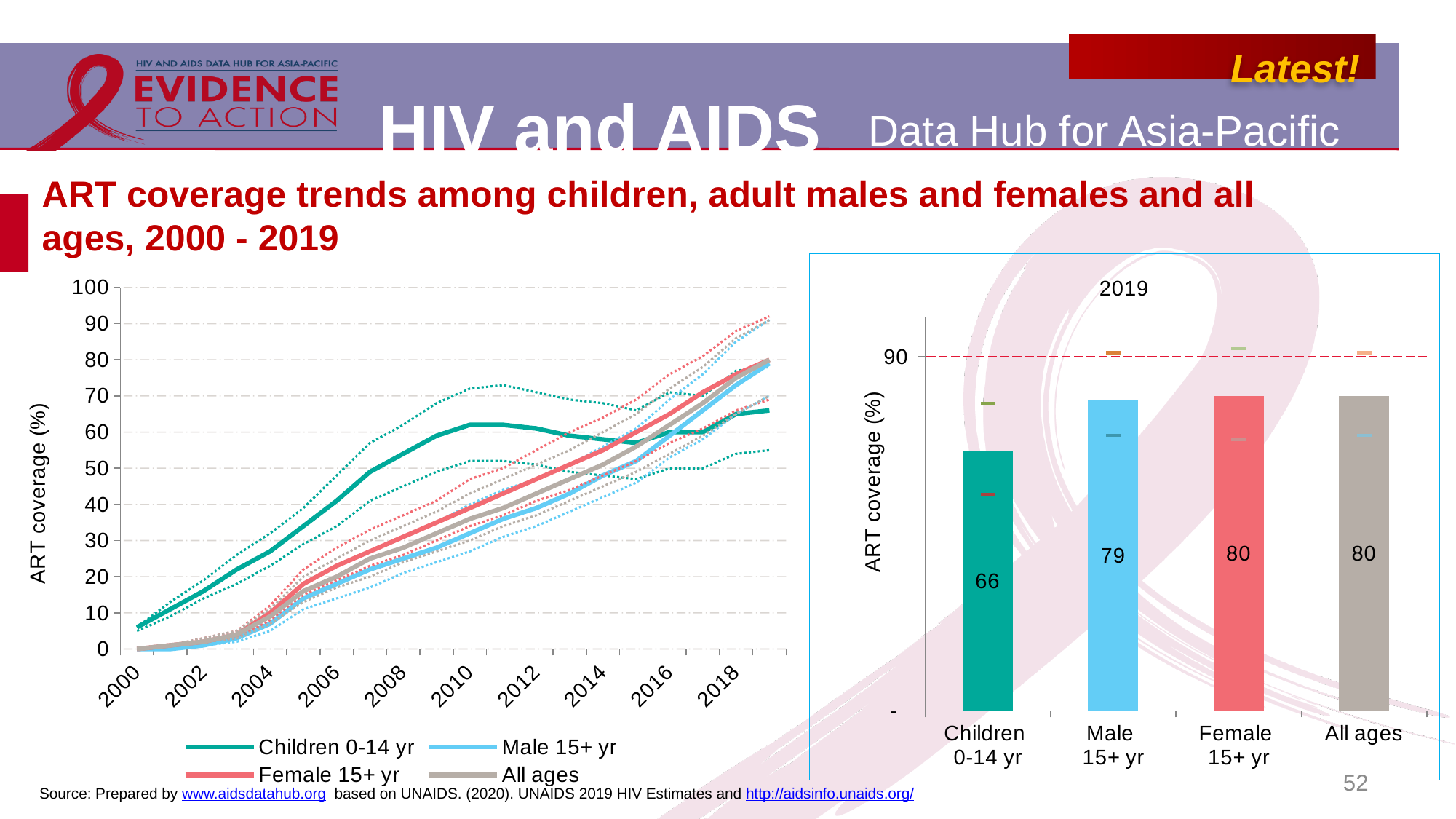
In the 2019 bar chart on the right, what is the ART coverage for Male 15+ yr? 79 In the 2019 bar chart on the right, which is larger, the value for Male 15+ yr or the value for Children 0-14 yr? Male 15+ yr How many series does the legend of the left line chart list? 4 How many categories are shown in the 2019 bar chart on the right? 4 In the 2019 bar chart on the right, what is the ART coverage for Children 0-14 yr? 66 What kind of chart is the chart on the left showing ART coverage from 2000 to 2019? line chart In the 2019 bar chart on the right, what is the difference in ART coverage between Female 15+ yr and Children 0-14 yr? 14 In the 2019 bar chart on the right, what is the ART coverage for Female 15+ yr? 80 In the 2019 bar chart on the right, is the value for All ages greater or less than 90? less In the left line chart, is the ART coverage for Children 0-14 yr in 2010 greater or less than 50? greater In the left line chart, does the ART coverage for Male 15+ yr rise or fall from 2000 to 2019? rise In the 2019 bar chart on the right, which category has the lowest ART coverage? Children 0-14 yr